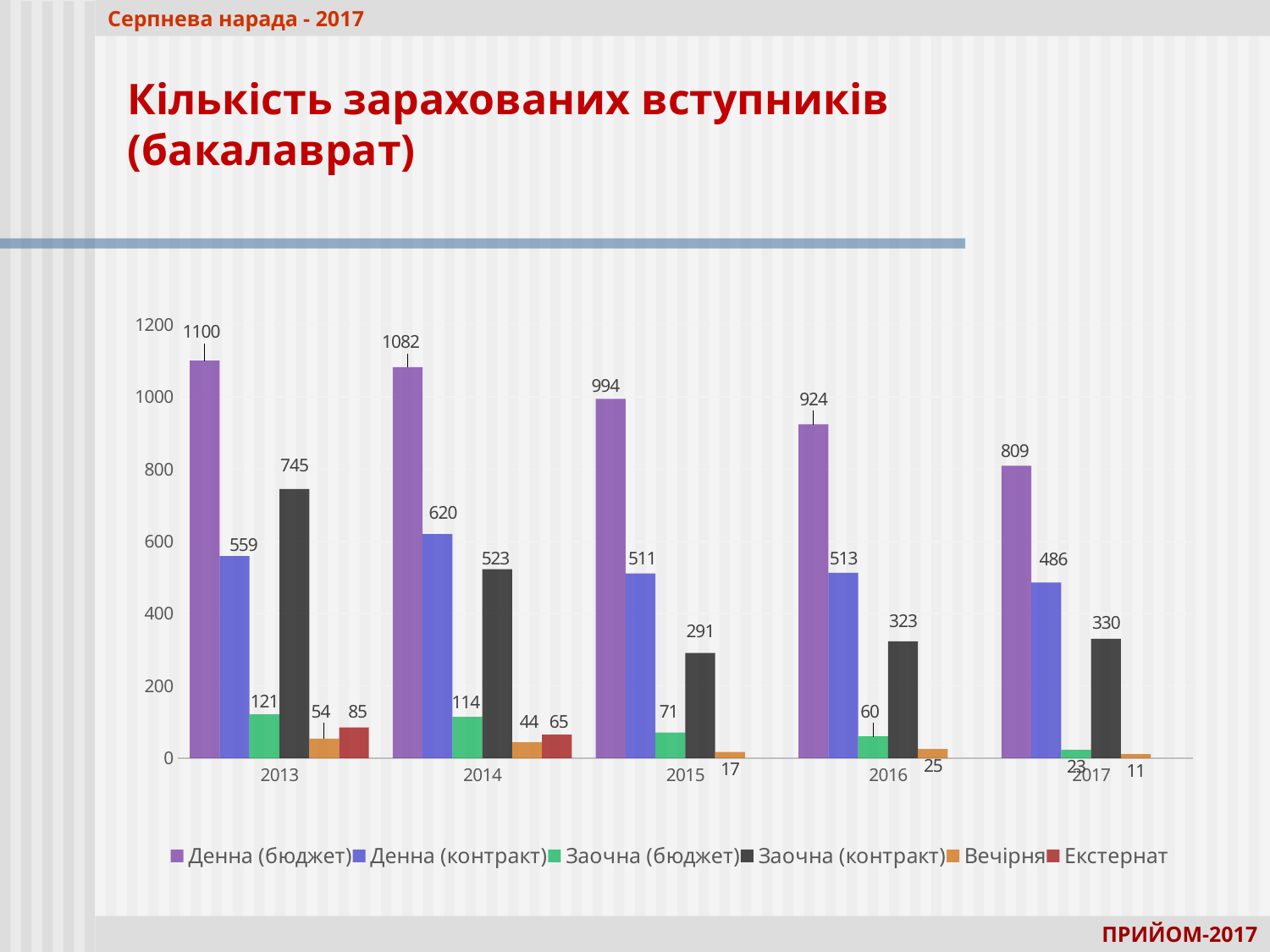
What is the difference between the Денна (бюджет) values for 2013 and 2017? 291 What is the value for Денна (бюджет) in 2013? 1100 In which year is the Денна (контракт) value the highest? 2014 What is the value for Заочна (контракт) in 2014? 523 What is the value for Екстернат in 2013? 85 How does the Денна (бюджет) value change from 2013 to 2017? It falls Which is larger, Заочна (контракт) in 2016 or Заочна (контракт) in 2017? 2017 In which year is the Денна (бюджет) value the lowest? 2017 How many years are shown on the x axis? 5 How many series does the legend list? 6 What is the value for Вечірня in 2017? 11 What type of chart is shown on the slide? Bar chart